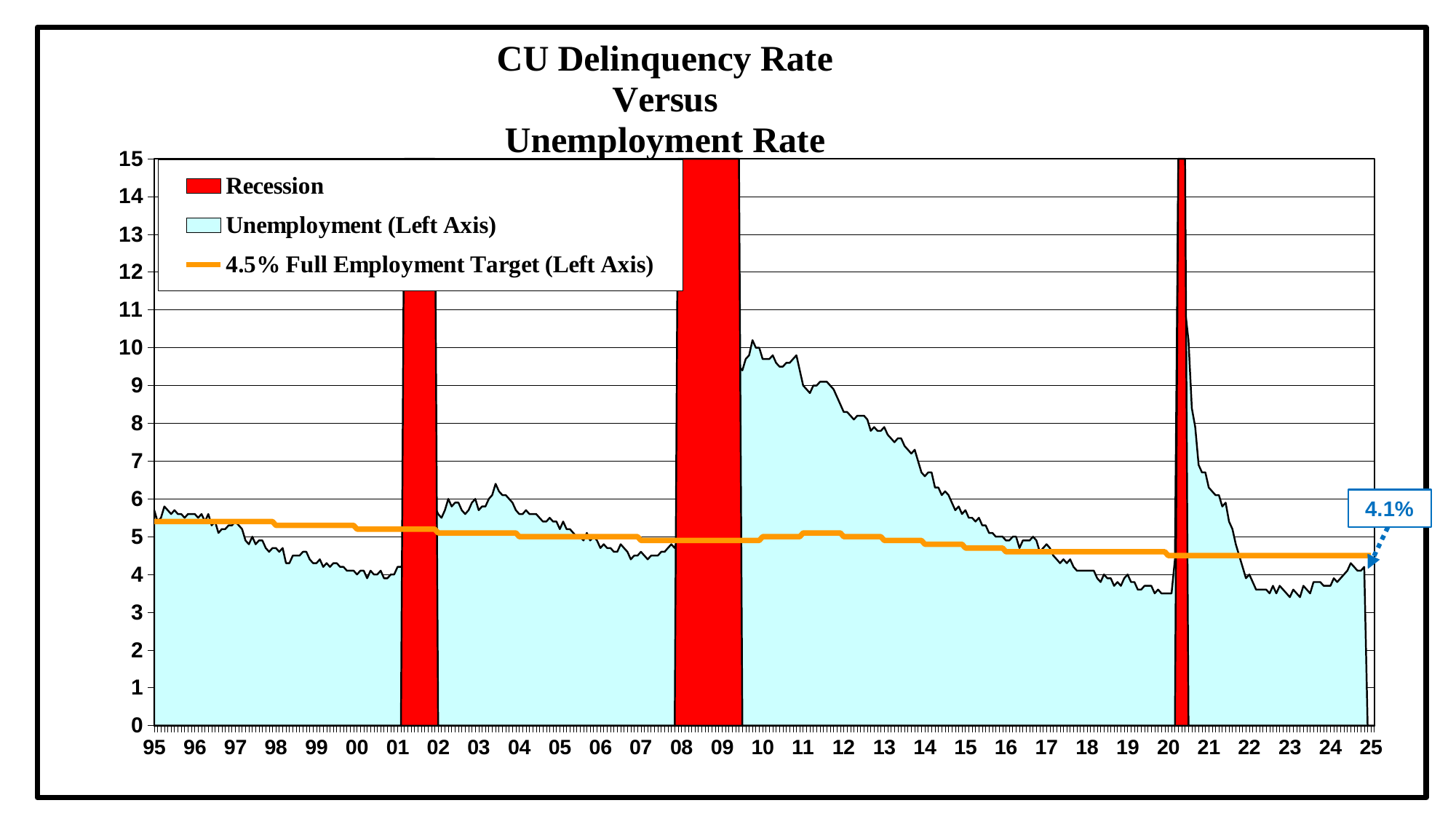
How many entries does the legend list? 3 What is the title of the chart? CU Delinquency Rate Versus Unemployment Rate What kind of chart is used to show the unemployment rate? area chart Is the unemployment rate in 2010 greater or less than 8? greater What is the highest value shown on the left axis? 15 How many recession periods are shaded on the chart? 3 Between 2010 and 2019, does the unemployment rate rise or fall? fall What colour is used for the Recession periods in the legend? red Is the unemployment rate in 2019 greater or less than 5? less Which year has the higher unemployment rate, 2010 or 2000? 2010 Is the unemployment rate in 2000 greater or less than 5? less What is the unemployment rate value labeled at the end of the series in 2025? 4.1%